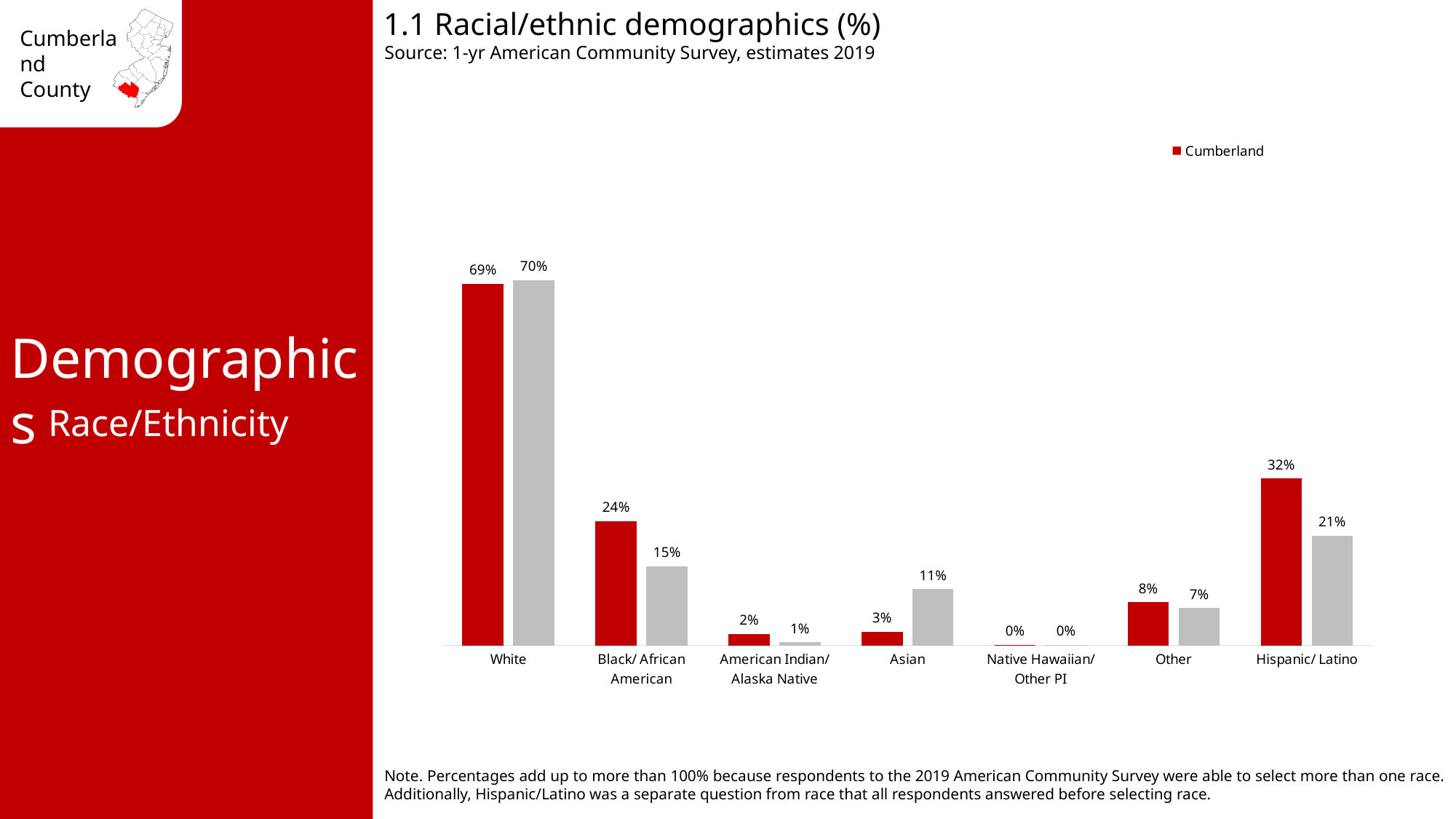
Which category has the lowest Cumberland value? Native Hawaiian/ Other PI How many series does the legend list? 1 What is the Cumberland value for Hispanic/ Latino? 32% What is the Cumberland value for White? 69% How many categories are shown on the x axis? 7 What is the difference between the Cumberland values for White and Hispanic/ Latino? 37% What kind of chart is shown on the slide? bar chart What is the title of the chart? 1.1 Racial/ethnic demographics (%) What is the Cumberland value for Other? 8% Which category has the highest Cumberland value? White Which has the larger Cumberland value, Black/ African American or Hispanic/ Latino? Hispanic/ Latino What is the Cumberland value for Black/ African American? 24%